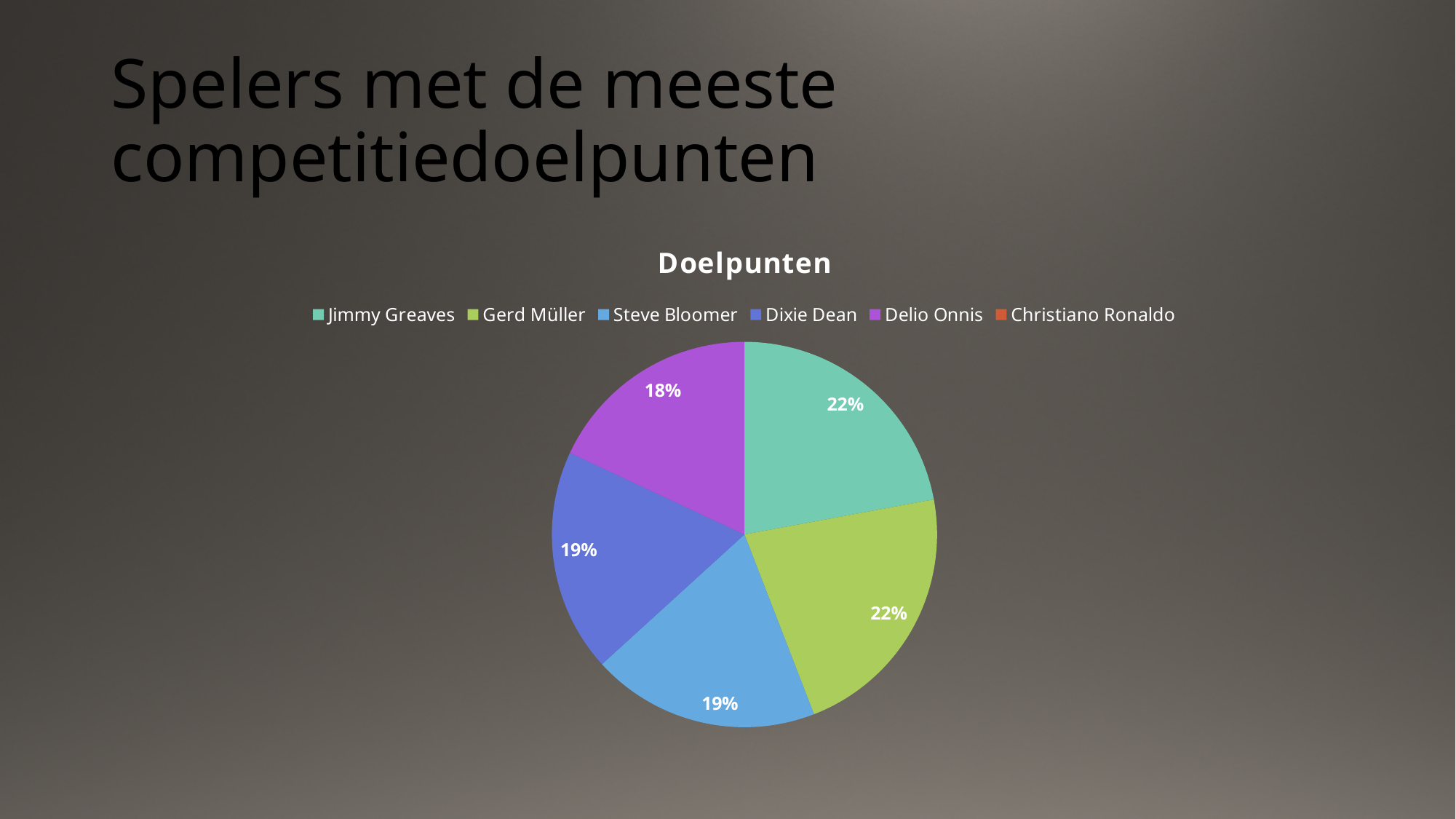
What share of the pie does Jimmy Greaves have? 22% What share of the pie does Steve Bloomer have? 19% Which player has the smallest labelled slice of the pie? Delio Onnis What is the title of the chart? Doelpunten What share of the pie does Gerd Müller have? 22% Which is larger, the slice for Gerd Müller or the slice for Steve Bloomer? Gerd Müller Which is larger, the slice for Jimmy Greaves or the slice for Delio Onnis? Jimmy Greaves What kind of chart is shown on the slide? Pie chart How many percentage points larger is Jimmy Greaves's share than Delio Onnis's share? 4 percentage points How many players are listed in the chart legend? 6